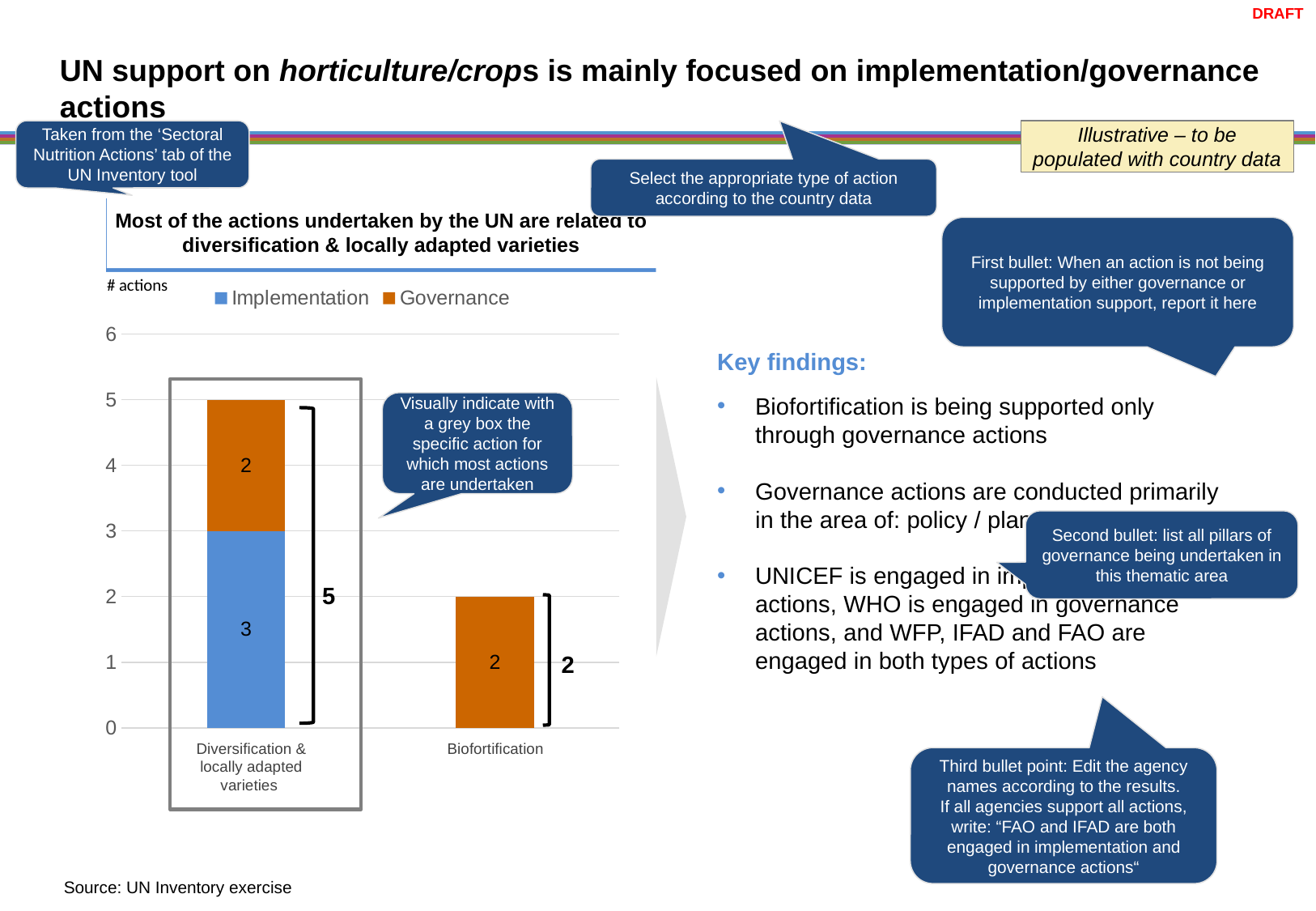
What is the total number of actions for Diversification & locally adapted varieties? 5 What is the total number of actions for Biofortification? 2 What is the Governance value for Biofortification? 2 What is the Governance value for Diversification & locally adapted varieties? 2 Which series is shown in orange in the chart legend? Governance How many series does the chart legend list? 2 Which is larger: the Implementation value for Diversification & locally adapted varieties or the Governance value for Biofortification? Implementation value for Diversification & locally adapted varieties Which category has the highest total number of actions? Diversification & locally adapted varieties What type of chart is shown on the slide? Stacked bar chart What is the difference between the total actions for Diversification & locally adapted varieties and Biofortification? 3 What is the Implementation value for Diversification & locally adapted varieties? 3 How many categories are shown on the x axis of the chart? 2